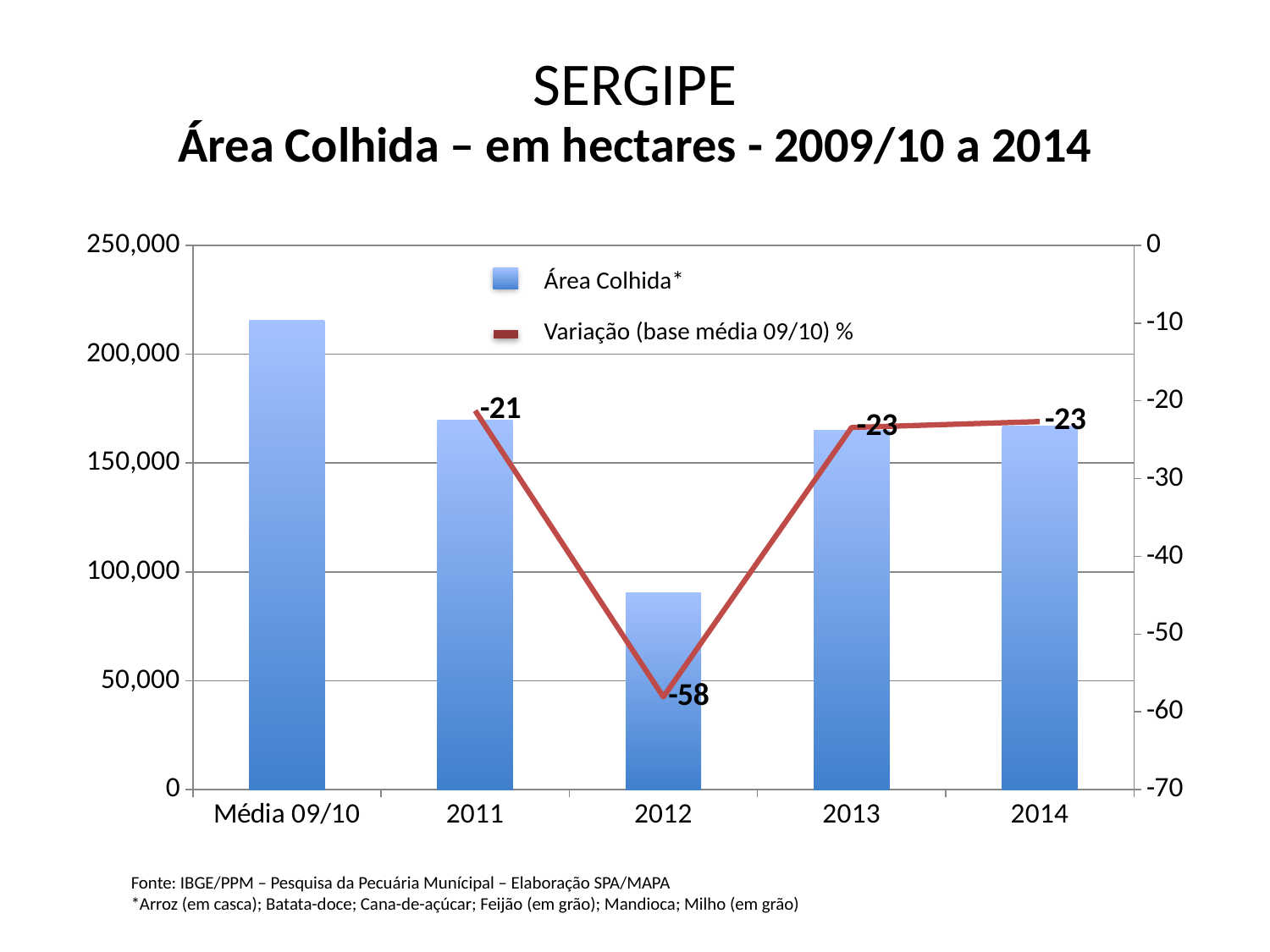
Is the Área Colhida value for 2012 greater or less than 100,000? less Which category has the shortest Área Colhida bar? 2012 Which is larger, the Área Colhida bar for 2012 or for 2013? 2013 Which year has the lowest value for Variação (base média 09/10) %? 2012 What is the value of Variação (base média 09/10) % for 2012? -58 How many categories are shown on the x axis? 5 Which category has the tallest Área Colhida bar? Média 09/10 Is the Área Colhida value for Média 09/10 greater or less than 200,000? greater What is the value of Variação (base média 09/10) % for 2011? -21 What is the value of Variação (base média 09/10) % for 2014? -23 How many series does the legend list? 2 What is the difference between the Variação values for 2011 and 2012? 37